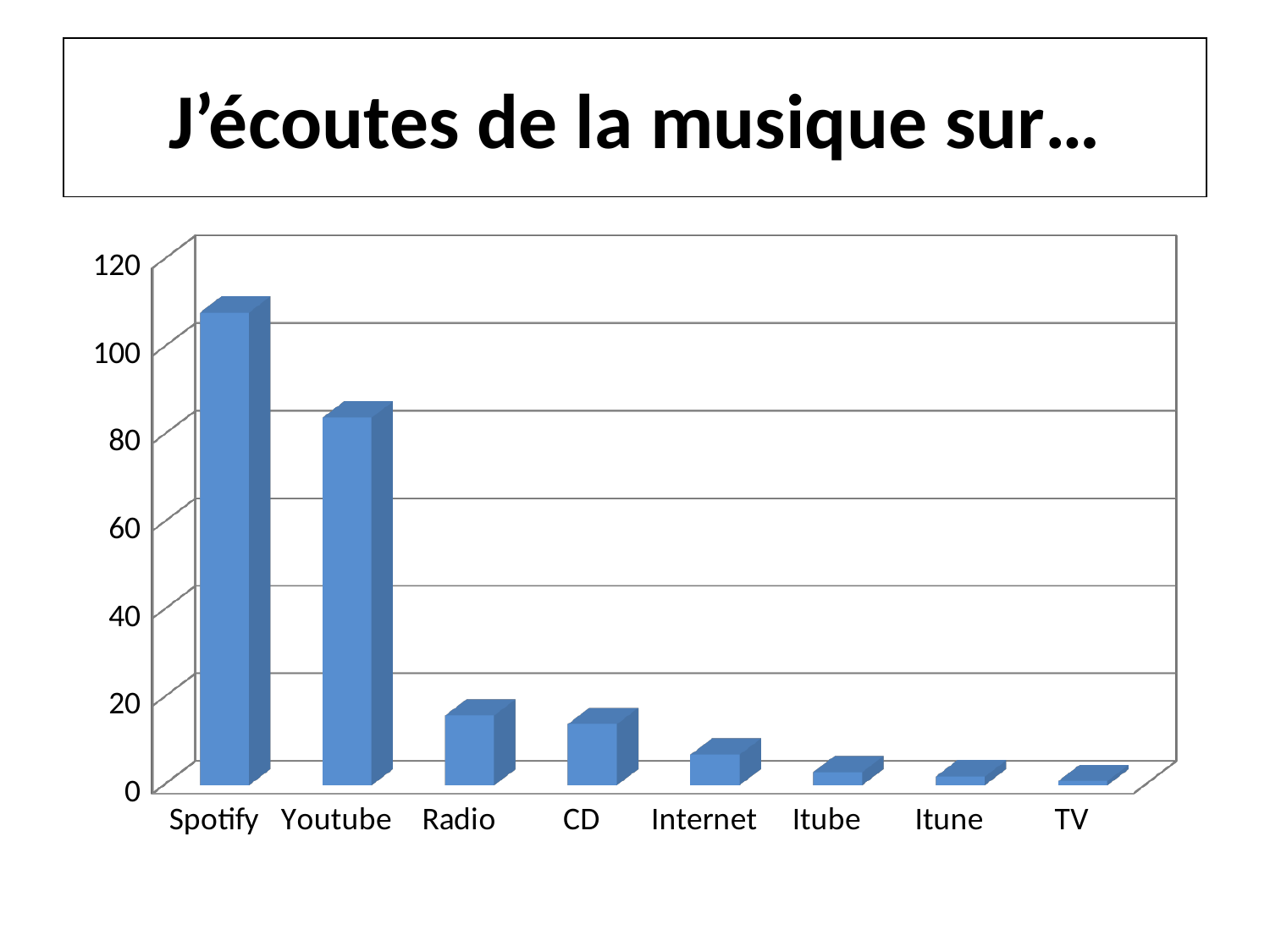
Which category has the highest value in the chart? Spotify What is the title of the slide containing the chart? J’écoutes de la musique sur… Is the value for Internet greater or less than 20? less Is the value for Spotify greater or less than 100? greater Is the value for Radio greater or less than 20? less What kind of chart is shown on the slide? Bar chart Which is larger, the value for Spotify or the value for Youtube? Spotify Which is larger, the value for Radio or the value for Internet? Radio How many categories are shown on the x axis of the chart? 8 Which is larger, the value for Youtube or the value for Radio? Youtube Do the values rise or fall moving from left to right along the x axis? fall